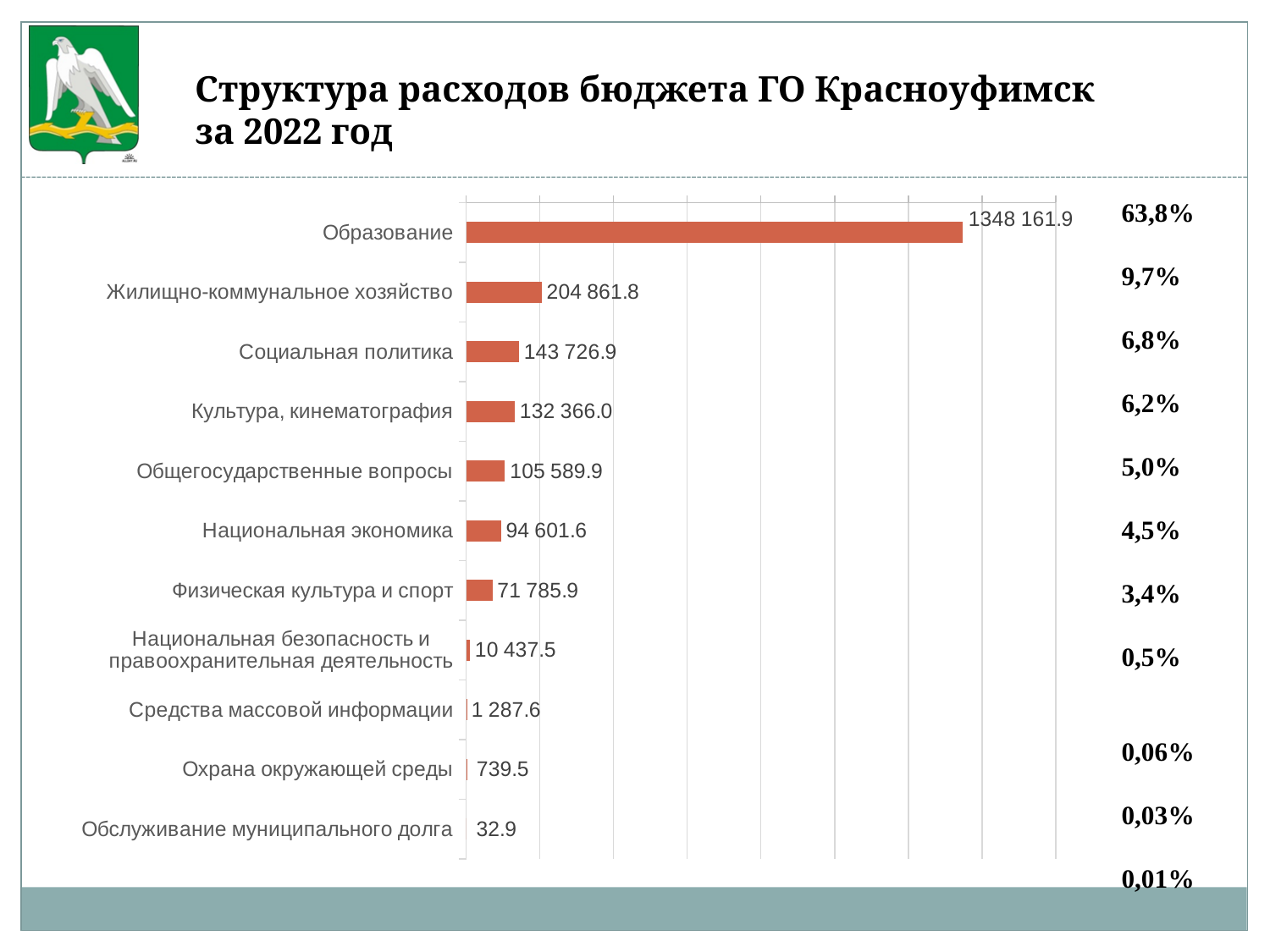
What is the difference between the values for Общегосударственные вопросы and Национальная экономика? 10 988.3 How many categories are shown in the chart? 11 Which is larger, the value for Социальная политика or the value for Культура, кинематография? Социальная политика What is the value for Культура, кинематография? 132 366.0 Which category has the lowest value? Обслуживание муниципального долга What is the value for Образование? 1348 161.9 What is the difference between the values for Жилищно-коммунальное хозяйство and Социальная политика? 61 134.9 What is the value for Охрана окружающей среды? 739.5 What is the value for Физическая культура и спорт? 71 785.9 What is the value for Жилищно-коммунальное хозяйство? 204 861.8 What kind of chart is shown on the slide? Bar chart Which category has the highest value? Образование